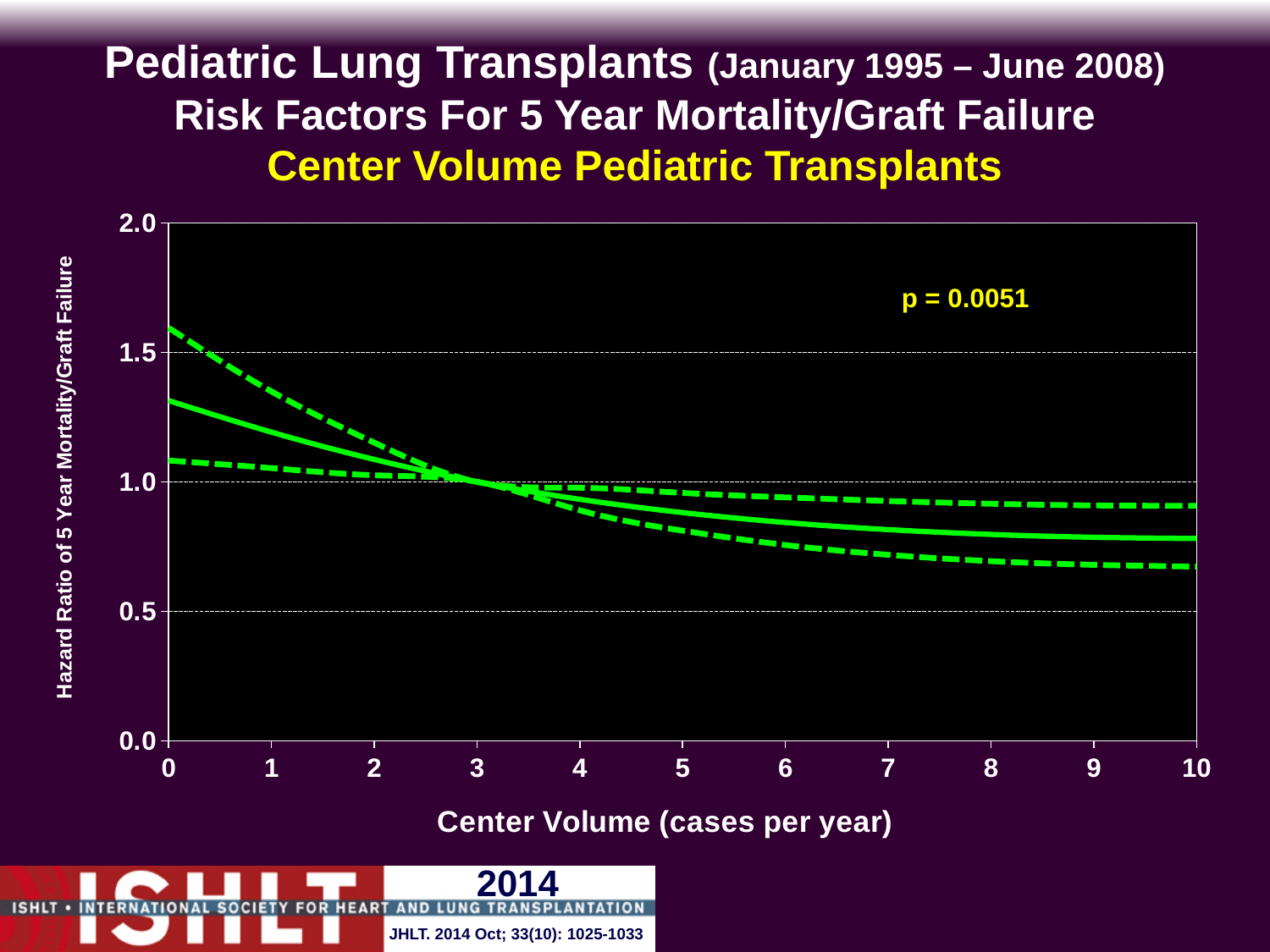
What is the label of the x axis? Center Volume (cases per year) Is the lower dashed line at a center volume of 10 cases per year greater or less than 0.5? greater How many lines are plotted on the chart? 3 Is the hazard ratio on the solid line larger at a center volume of 0 or at a center volume of 10 cases per year? 0 What p-value is printed on the chart? p = 0.0051 Does the solid line (hazard ratio) rise or fall as center volume increases from 0 to 10 cases per year? fall What kind of chart is shown on the slide? line chart Is the upper dashed line at a center volume of 0 cases per year greater or less than 1.5? greater At a center volume of 10 cases per year, which dashed line has the larger value, the upper or the lower one? the upper one Is the hazard ratio on the solid line at a center volume of 0 cases per year greater or less than 1.0? greater